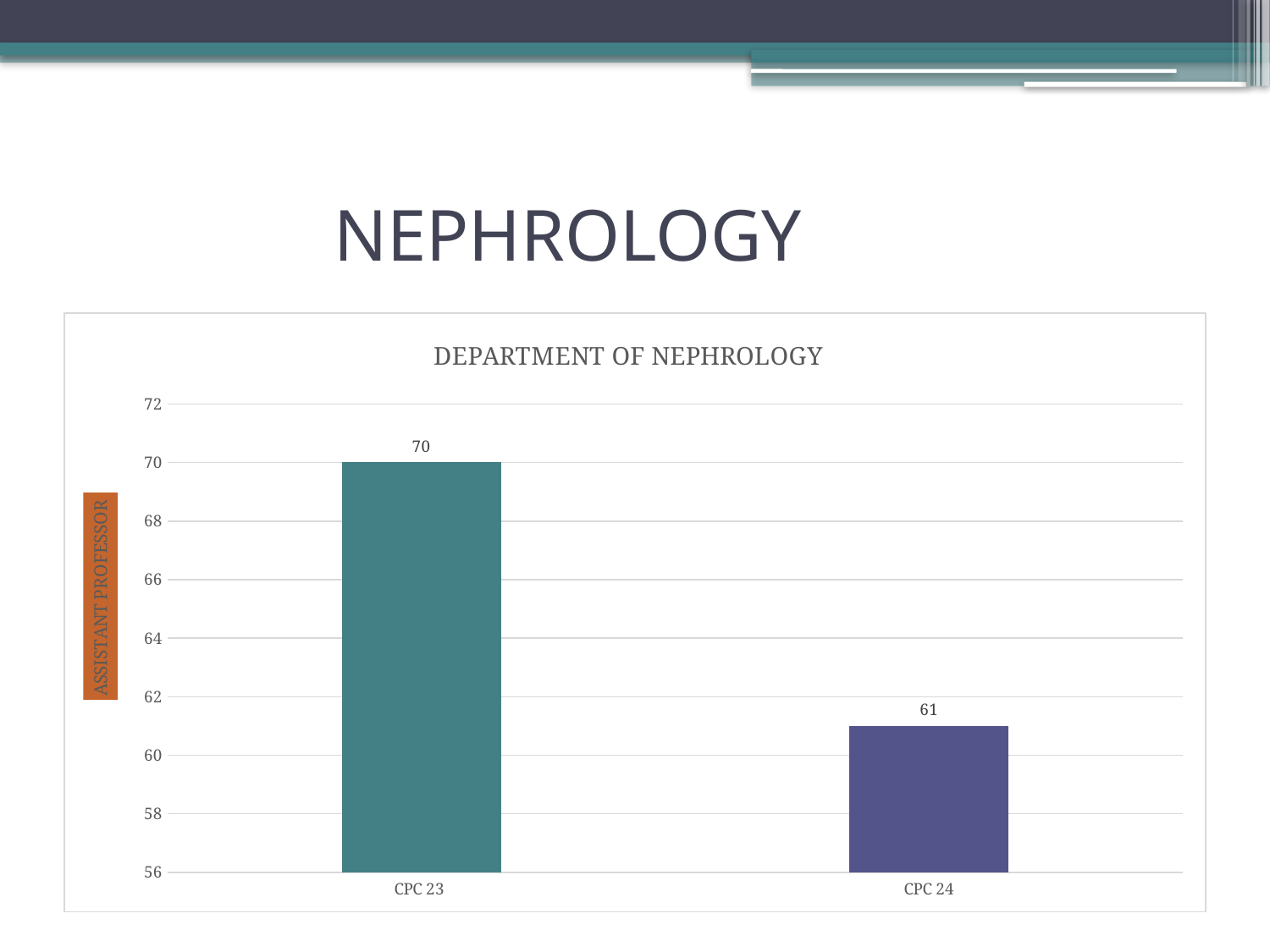
What is the value for CPC 23? 70 What is the title of the chart? DEPARTMENT OF NEPHROLOGY Which category has the highest value? CPC 23 How many categories are shown on the x axis? 2 Do the values rise or fall from CPC 23 to CPC 24? fall Is the value for CPC 24 greater or less than 62? less Which category has the lowest value? CPC 24 What kind of chart is shown on the slide? bar chart Which is larger, the value for CPC 23 or the value for CPC 24? CPC 23 What is the difference between the values for CPC 23 and CPC 24? 9 Is the value for CPC 23 greater or less than 68? greater What is the value for CPC 24? 61